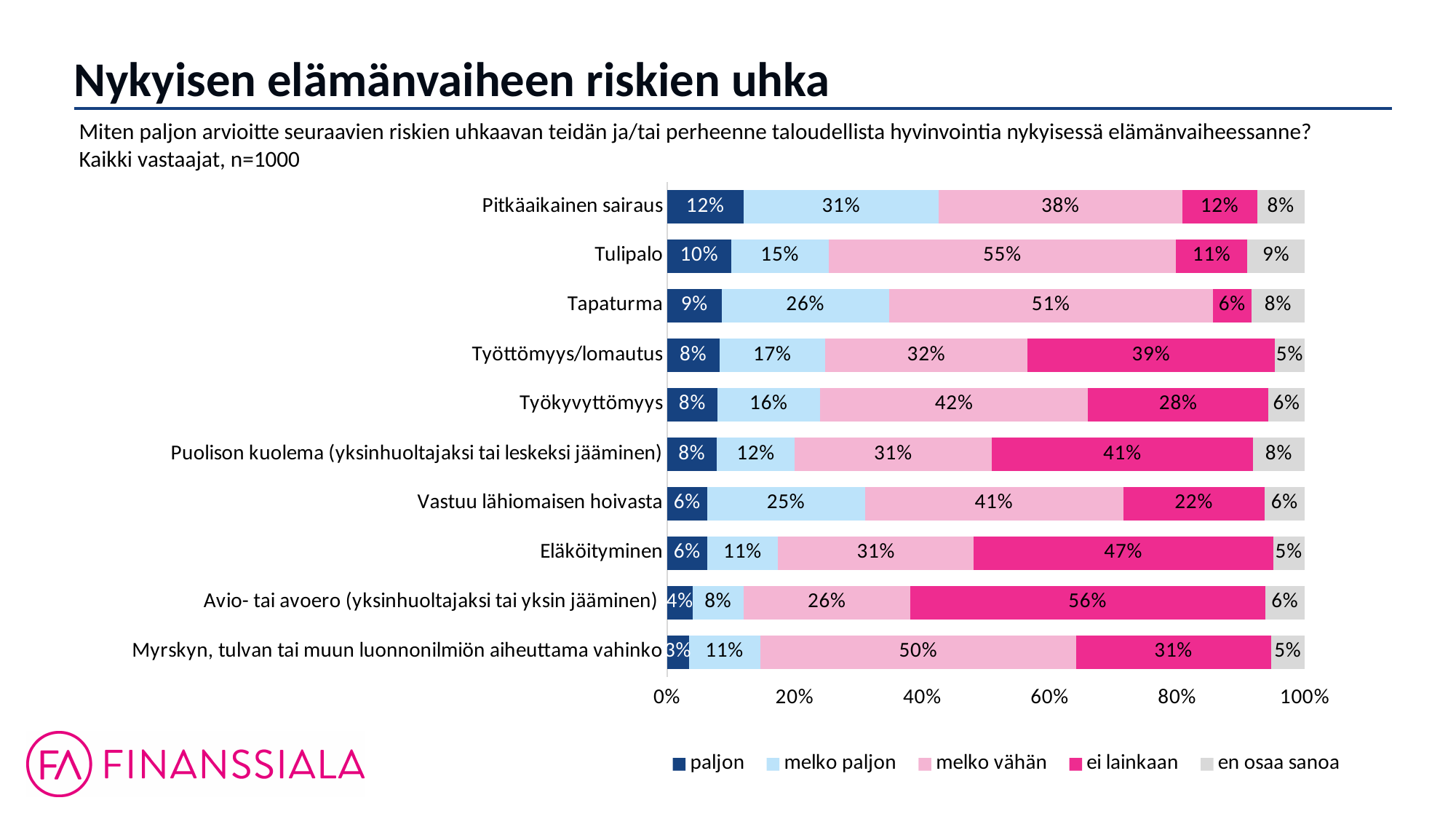
What percentage of respondents answered "melko vähän" for Tulipalo? 55% What is the "ei lainkaan" value for Eläköityminen? 47% Which legend entry is shown in dark blue? paljon What is the total of the Tulipalo bar when its segments are added together? 100% How many series does the legend list? 5 Which category has the highest "ei lainkaan" share? Avio- tai avoero (yksinhuoltajaksi tai yksin jääminen) How many risk categories are shown in the chart? 10 Which category has the lowest "paljon" share? Myrskyn, tulvan tai muun luonnonilmiön aiheuttama vahinko What is the difference between the "melko paljon" values for Pitkäaikainen sairaus and Tapaturma? 5% What kind of chart is shown on the slide? Stacked bar chart Which has a larger "ei lainkaan" share, Työttömyys/lomautus or Työkyvyttömyys? Työttömyys/lomautus What is the "paljon" value for Pitkäaikainen sairaus? 12%